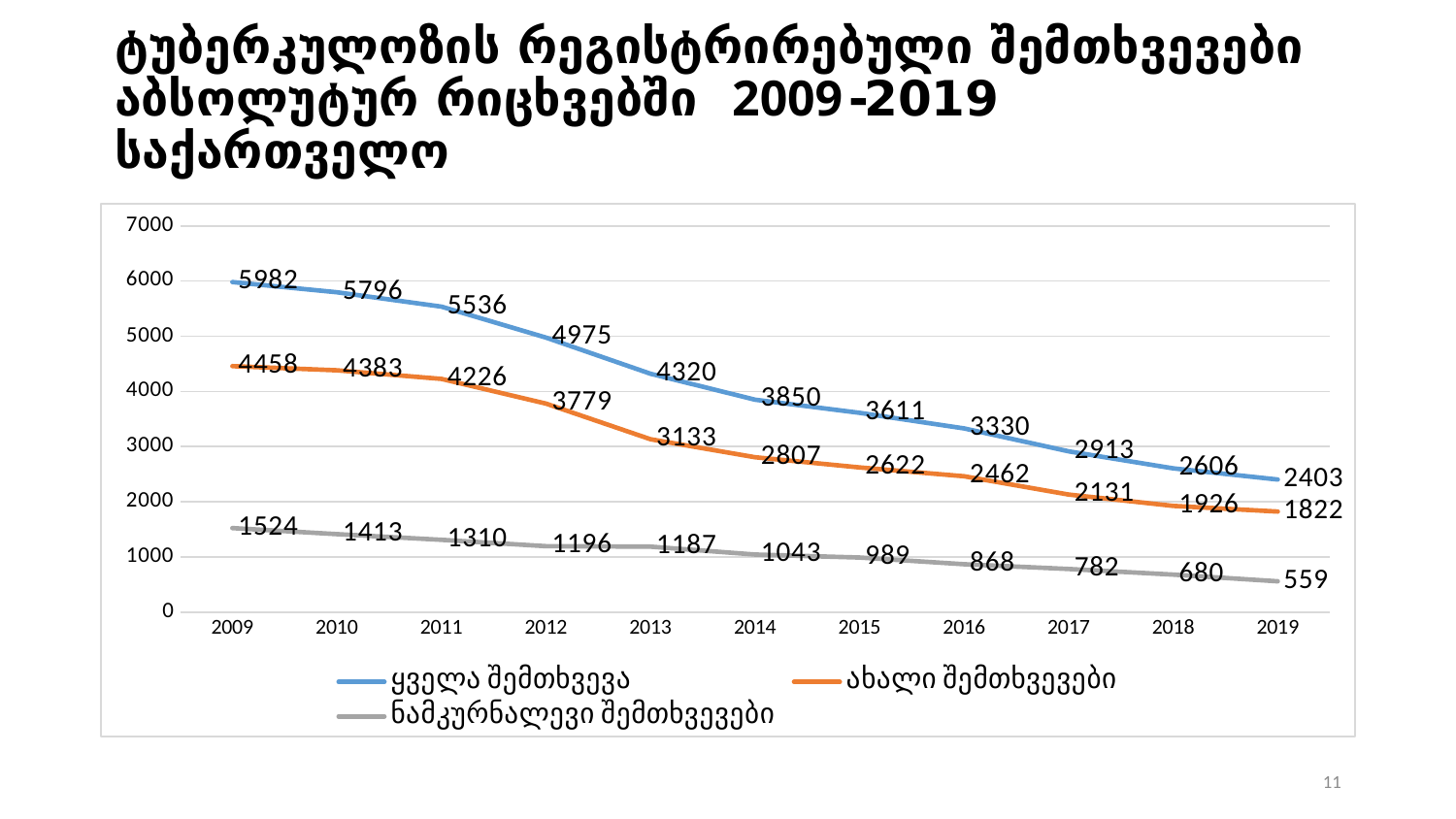
In which year is the ყველა შემთხვევა series at its lowest? 2019 What is the value of the ახალი შემთხვევები series in 2013? 3133 Which colour is used for the ახალი შემთხვევები series? orange What is the value of the ყველა შემთხვევა series in 2009? 5982 How many series does the legend list? 3 How many years are plotted along the x axis? 11 In which year is the ახალი შემთხვევები series at its highest? 2009 Do the values of the ნამკურნალევი შემთხვევები series rise or fall from 2009 to 2019? fall What is the value of the ნამკურნალევი შემთხვევები series in 2019? 559 What is the difference between the ყველა შემთხვევა values in 2009 and 2019? 3579 Which is larger in 2015: the ახალი შემთხვევები value or the ნამკურნალევი შემთხვევები value? ახალი შემთხვევები What type of chart is shown on the slide? line chart